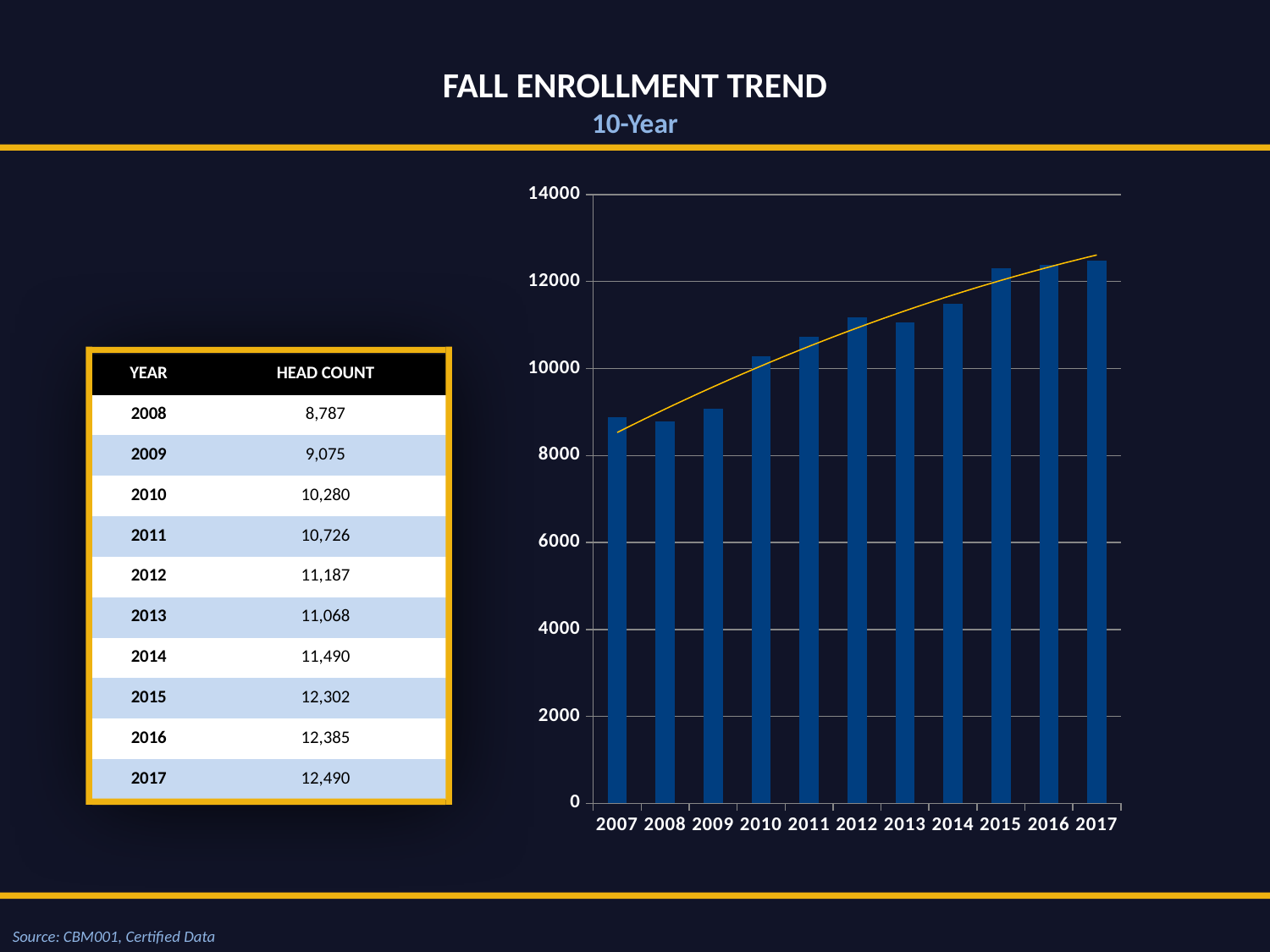
Which year has the larger head count, 2009 or 2010? 2010 What is the head count for 2013? 11,068 What is the head count for 2010? 10,280 What is the difference in head count between 2017 and 2008? 3,703 Do the enrollment values generally rise or fall from 2007 to 2017? rise Is the value for 2014 greater or less than 12000? less How many years are shown on the x axis of the chart? 11 What is the difference in head count between 2012 and 2013? 119 What kind of chart is shown on the slide? bar chart Is the value for 2007 greater or less than 8000? greater Which year has the highest head count? 2017 What is the head count for 2017? 12,490